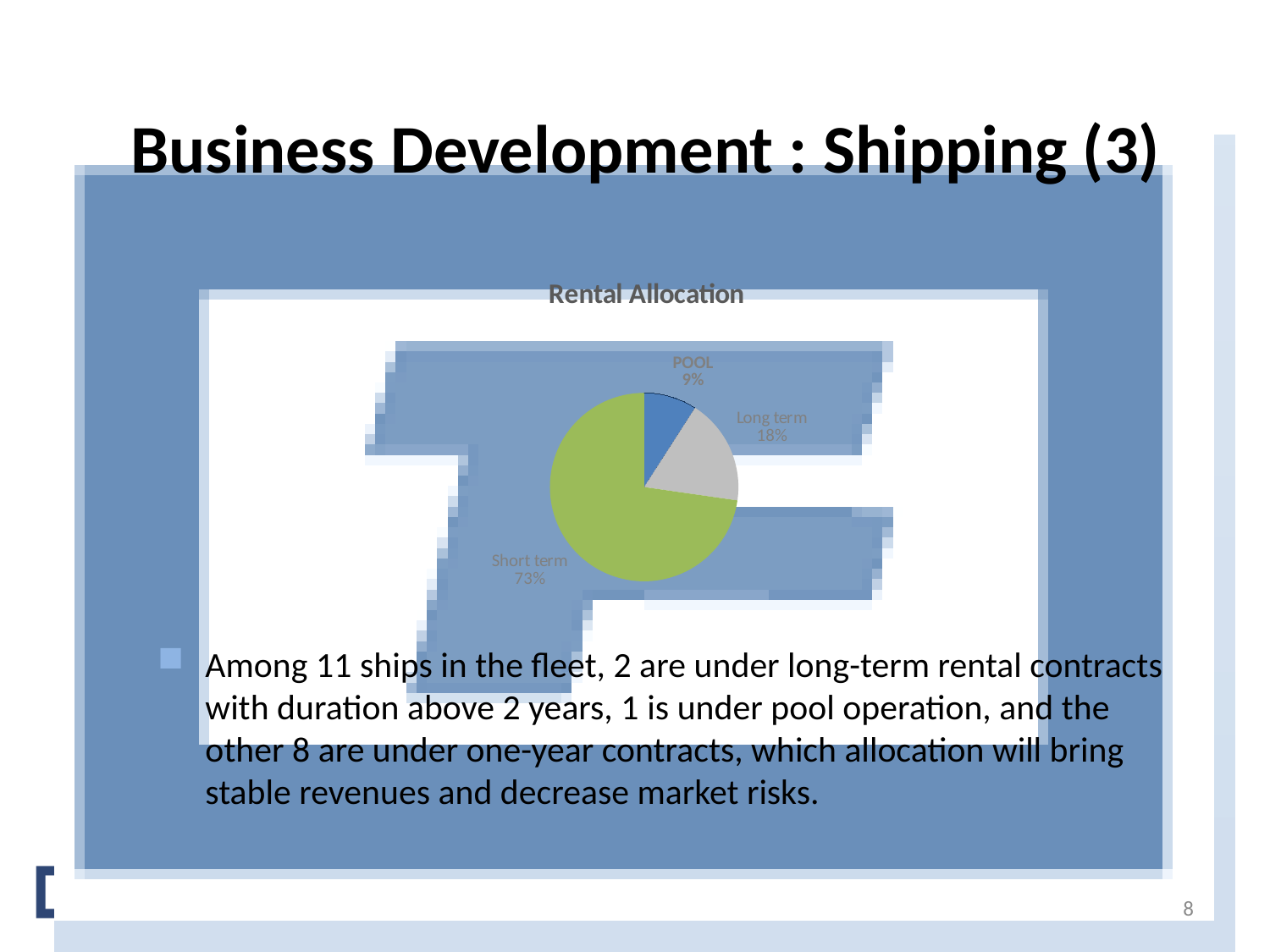
What share of the Rental Allocation pie is POOL? 9% What is the difference in percentage points between the Short term and Long term slices? 55 What is the difference in percentage points between the Long term and POOL slices? 9 What share of the Rental Allocation pie is Long term? 18% Which is larger in the Rental Allocation pie, Long term or POOL? Long term Which slice of the Rental Allocation pie is the largest? Short term What kind of chart is shown on the slide? pie chart Which slice of the Rental Allocation pie is the smallest? POOL What colour is the Short term slice in the Rental Allocation pie chart? green What share of the Rental Allocation pie is Short term? 73% How many slices does the Rental Allocation pie chart have? 3 What is the title of the chart? Rental Allocation